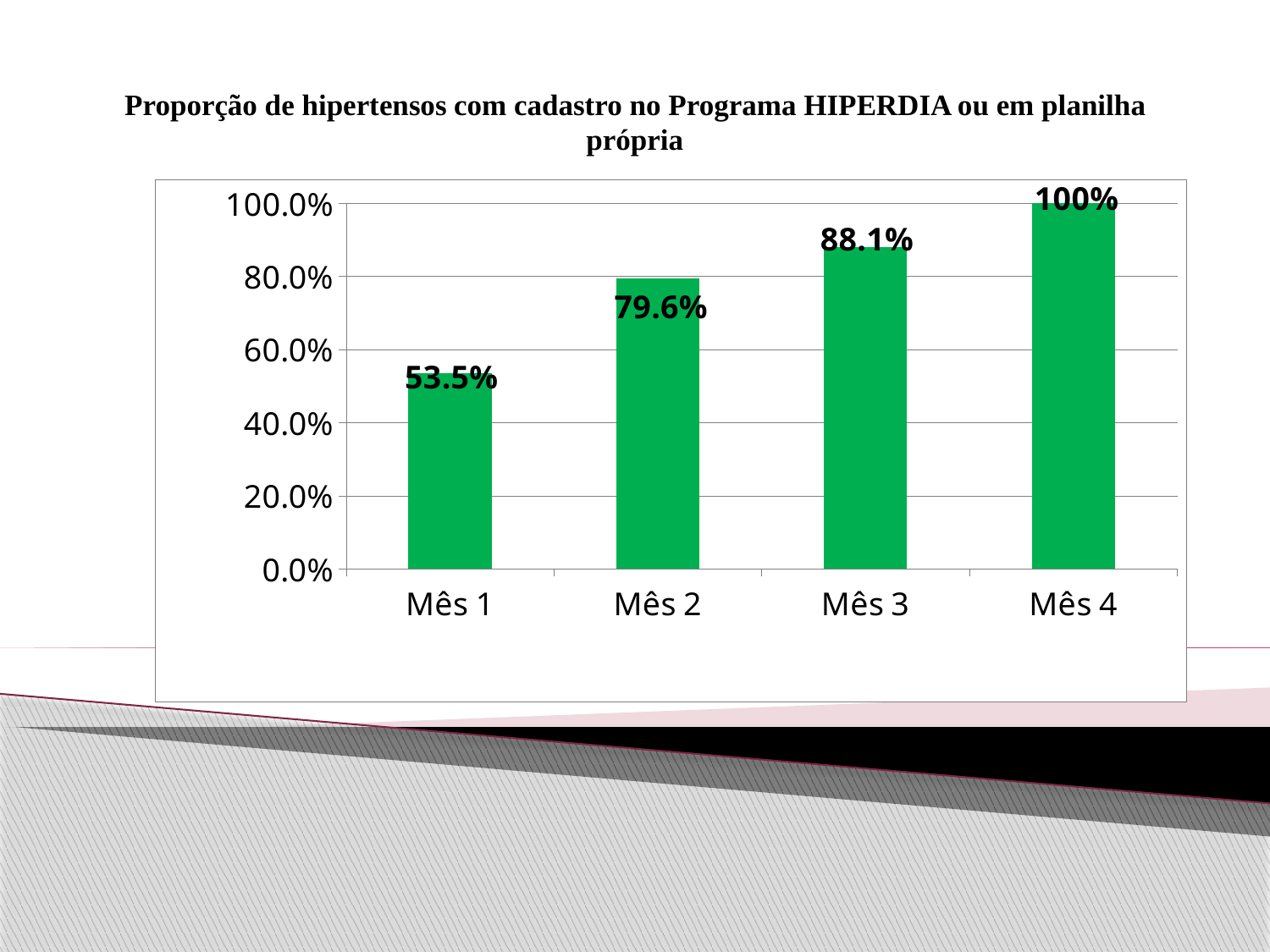
Which month has the highest value? Mês 4 Do the values rise or fall from Mês 1 to Mês 4? rise What is the difference between the values for Mês 2 and Mês 1? 26.1% What is the value for Mês 4? 100% How many months are shown on the x axis? 4 Which month has the lowest value? Mês 1 What is the value for Mês 3? 88.1% What is the value for Mês 1? 53.5% What is the value for Mês 2? 79.6% Is the value for Mês 1 greater or less than 60.0%? less What kind of chart is shown on the slide? bar chart Which is larger, the value for Mês 2 or the value for Mês 3? Mês 3